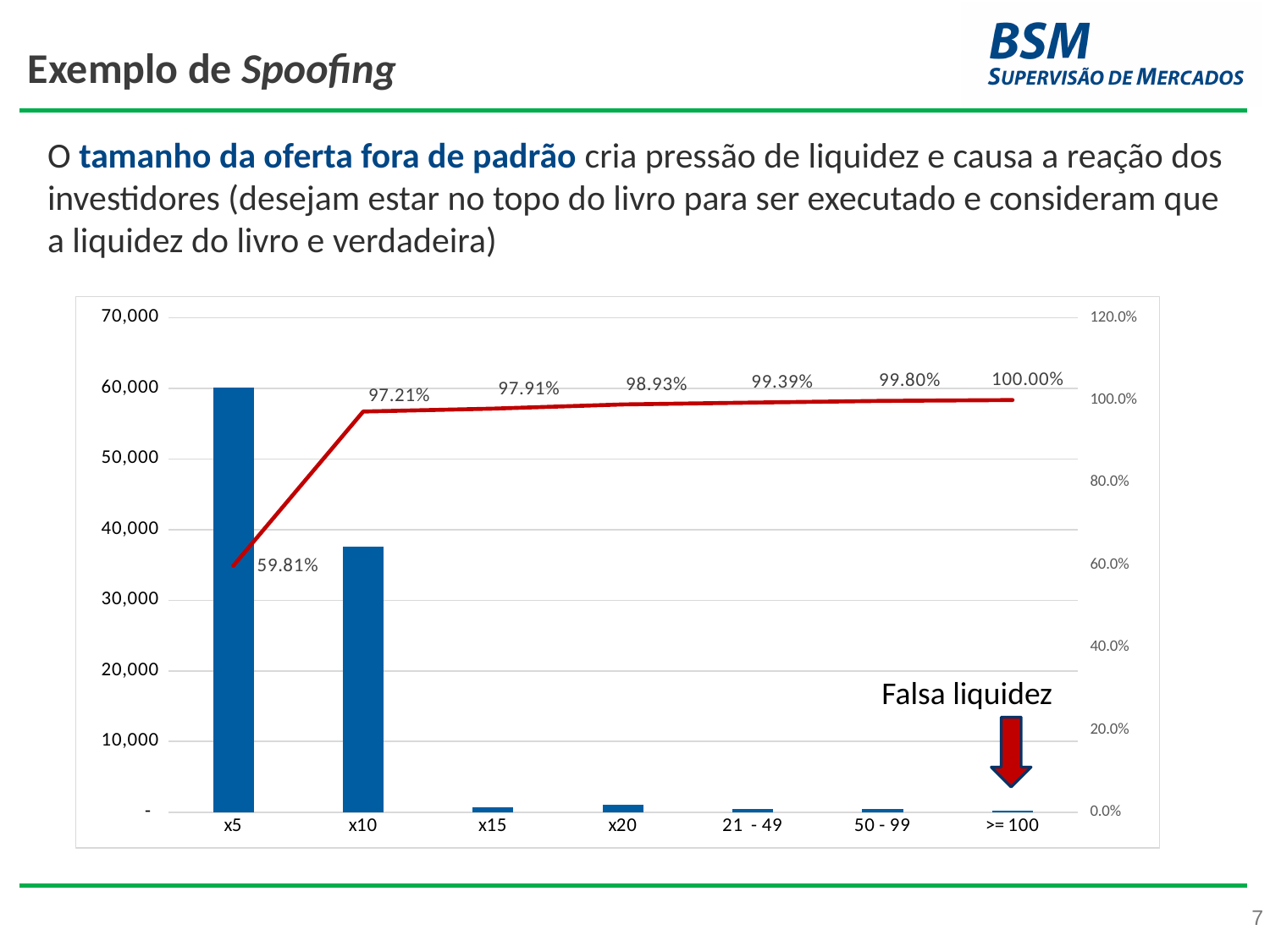
Which bar is taller, x10 or x15? x10 What is the cumulative percentage shown for the >= 100 category? 100.00% Does the red line rise or fall from x5 to >= 100? rise What is the difference between the cumulative percentages for x10 and x5? 37.40% Is the bar value for x20 greater or less than 10,000? less How many categories are shown on the x axis? 7 What is the cumulative percentage shown for the x5 category? 59.81% Which category has the tallest bar? x5 What is the cumulative percentage shown for the 21 - 49 category? 99.39% What is the cumulative percentage shown for the x10 category? 97.21% Is the bar value for x10 greater or less than 30,000? greater What text is written above the red arrow pointing at the >= 100 category? Falsa liquidez